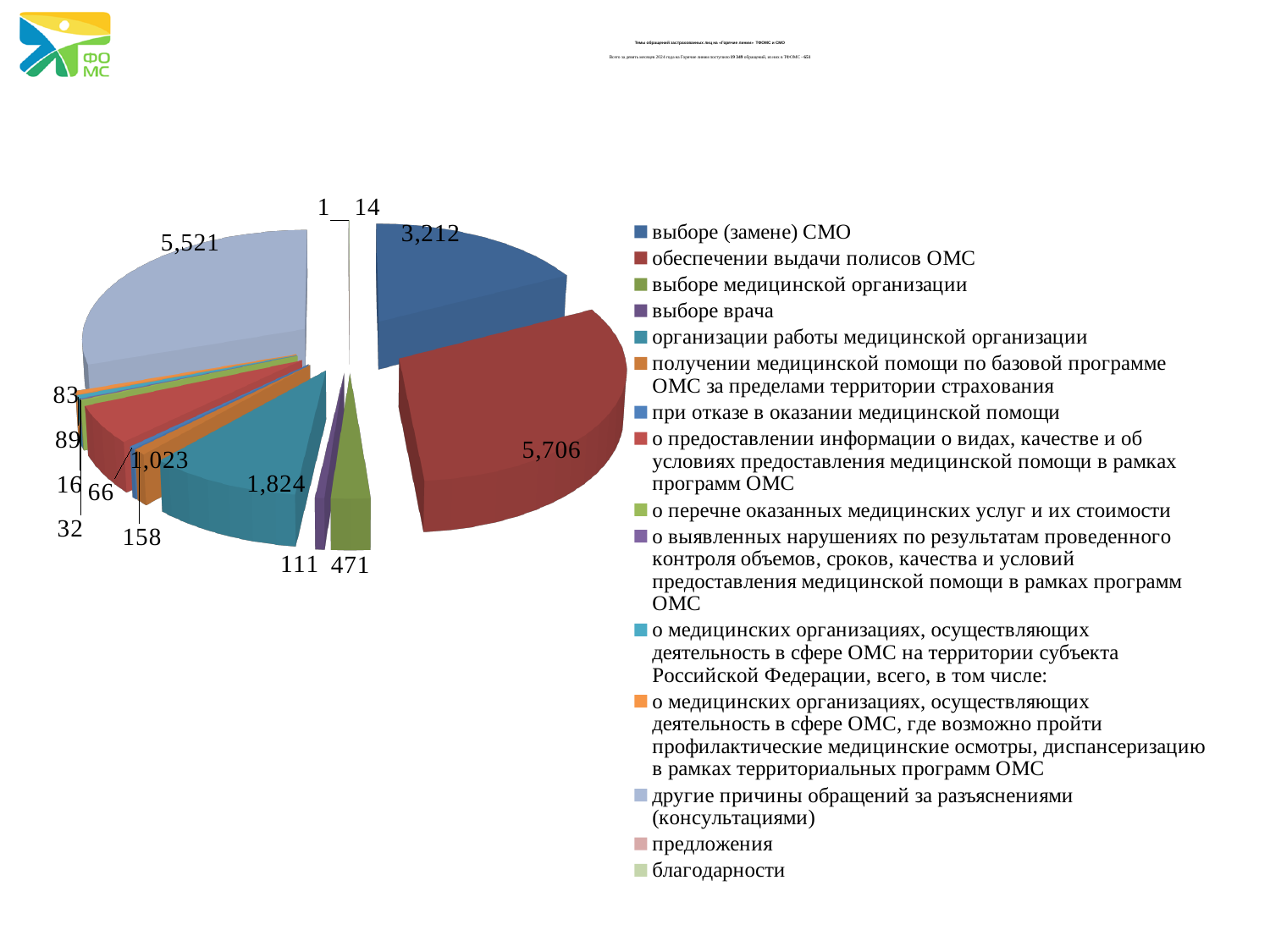
How many categories does the legend of the pie chart list? 15 What is the smallest value shown on the pie chart? 1 What is the value of the largest slice in the pie chart? 5,706 What is the value for 'выборе (замене) СМО'? 3,212 Which is larger: the slice for 'обеспечении выдачи полисов ОМС' or the slice for 'другие причины обращений за разъяснениями (консультациями)'? обеспечении выдачи полисов ОМС What is the value for 'другие причины обращений за разъяснениями (консультациями)'? 5,521 What is the difference between the values for 'обеспечении выдачи полисов ОМС' and 'выборе (замене) СМО'? 2,494 What kind of chart is shown on the slide? pie chart What is the value for 'организации работы медицинской организации'? 1,824 What colour is the slice for 'обеспечении выдачи полисов ОМС'? red What is the value for 'выборе медицинской организации'? 471 Which category has the largest slice in the pie chart? обеспечении выдачи полисов ОМС